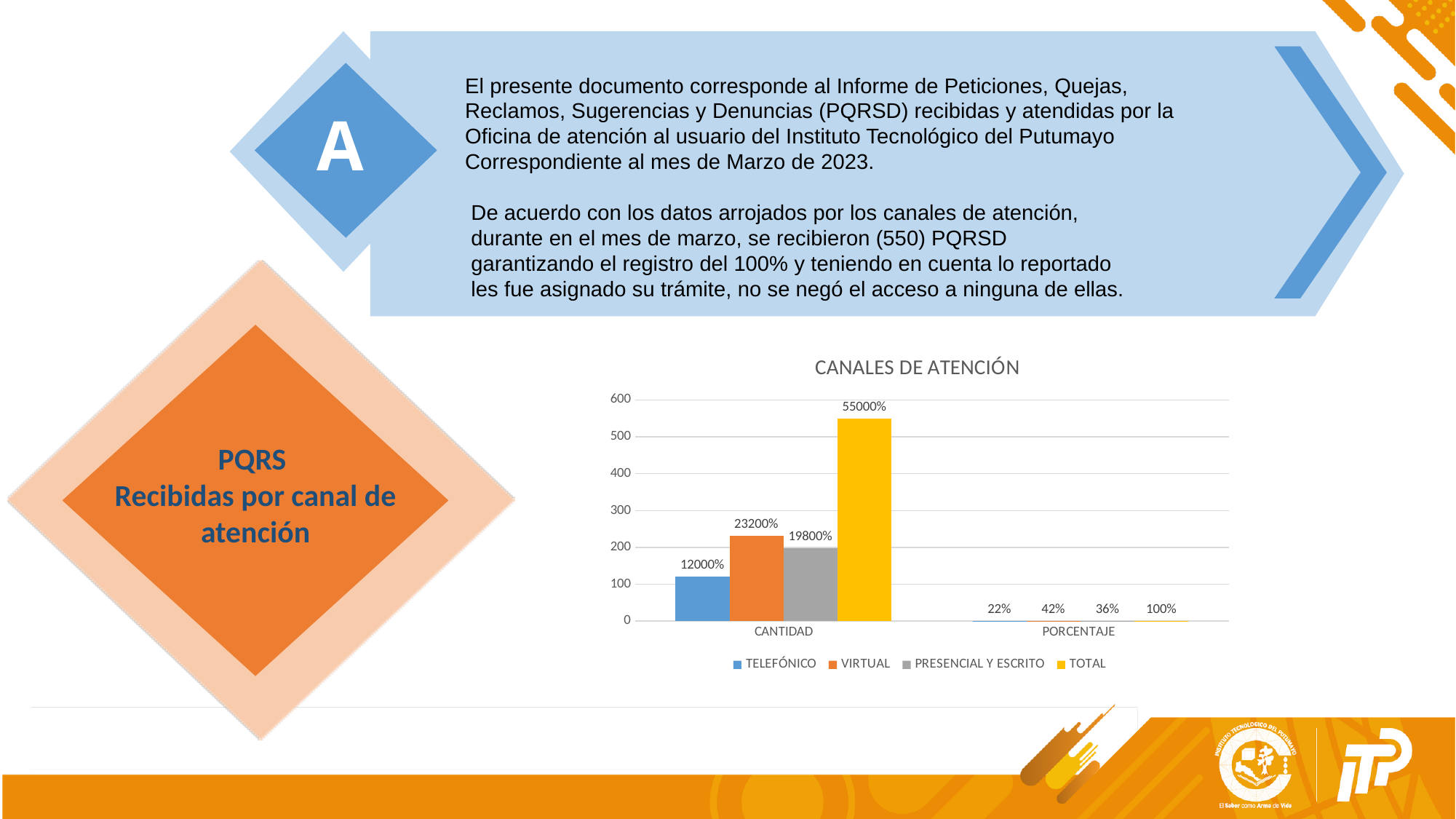
Is the VIRTUAL bar in the CANTIDAD category greater or less than 200 on the axis? greater In the CANTIDAD category, which bar is taller: VIRTUAL or PRESENCIAL Y ESCRITO? VIRTUAL What is the data label for PRESENCIAL Y ESCRITO in the CANTIDAD category? 19800% Which series has the tallest bar in the CANTIDAD category? TOTAL What is the data label for VIRTUAL in the PORCENTAJE category? 42% What is the difference between the VIRTUAL and TELEFÓNICO labels in the PORCENTAJE category? 20% What is the data label for TOTAL in the PORCENTAJE category? 100% Which series has the shortest bar in the CANTIDAD category? TELEFÓNICO How many series does the legend of the CANALES DE ATENCIÓN chart list? 4 What kind of chart is shown under the title CANALES DE ATENCIÓN? bar chart How many categories are shown on the x axis of the CANALES DE ATENCIÓN chart? 2 What is the data label for TELEFÓNICO in the CANTIDAD category? 12000%